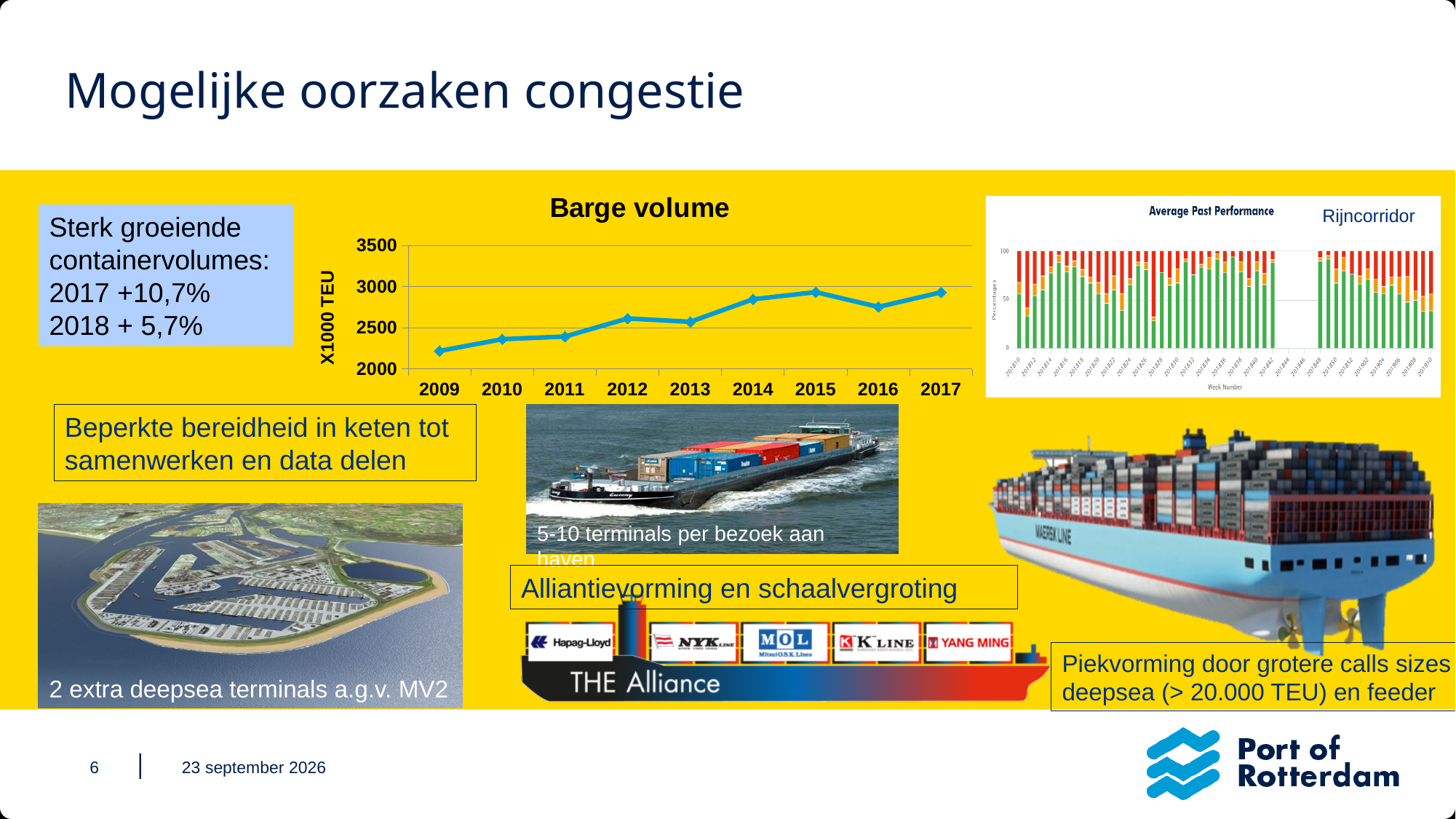
In the 'Barge volume' chart, is the value for 2014 greater or less than 3000? less How many years are plotted on the x axis of the 'Barge volume' chart? 9 In the 'Barge volume' chart, is the value for 2016 greater or less than 2500? greater In the 'Barge volume' chart, which year has the larger barge volume, 2012 or 2014? 2014 In the 'Barge volume' chart, is the value for 2009 greater or less than 2500? less In the 'Barge volume' chart, which year has the larger barge volume, 2015 or 2016? 2015 What kind of chart is the 'Average Past Performance' chart on the right of the slide? bar chart What is the y-axis label of the 'Barge volume' chart? X1000 TEU In the 'Barge volume' chart, does the barge volume generally rise or fall from 2009 to 2017? rise In the 'Barge volume' chart, which year has the lowest barge volume? 2009 What kind of chart is the 'Barge volume' chart? line chart